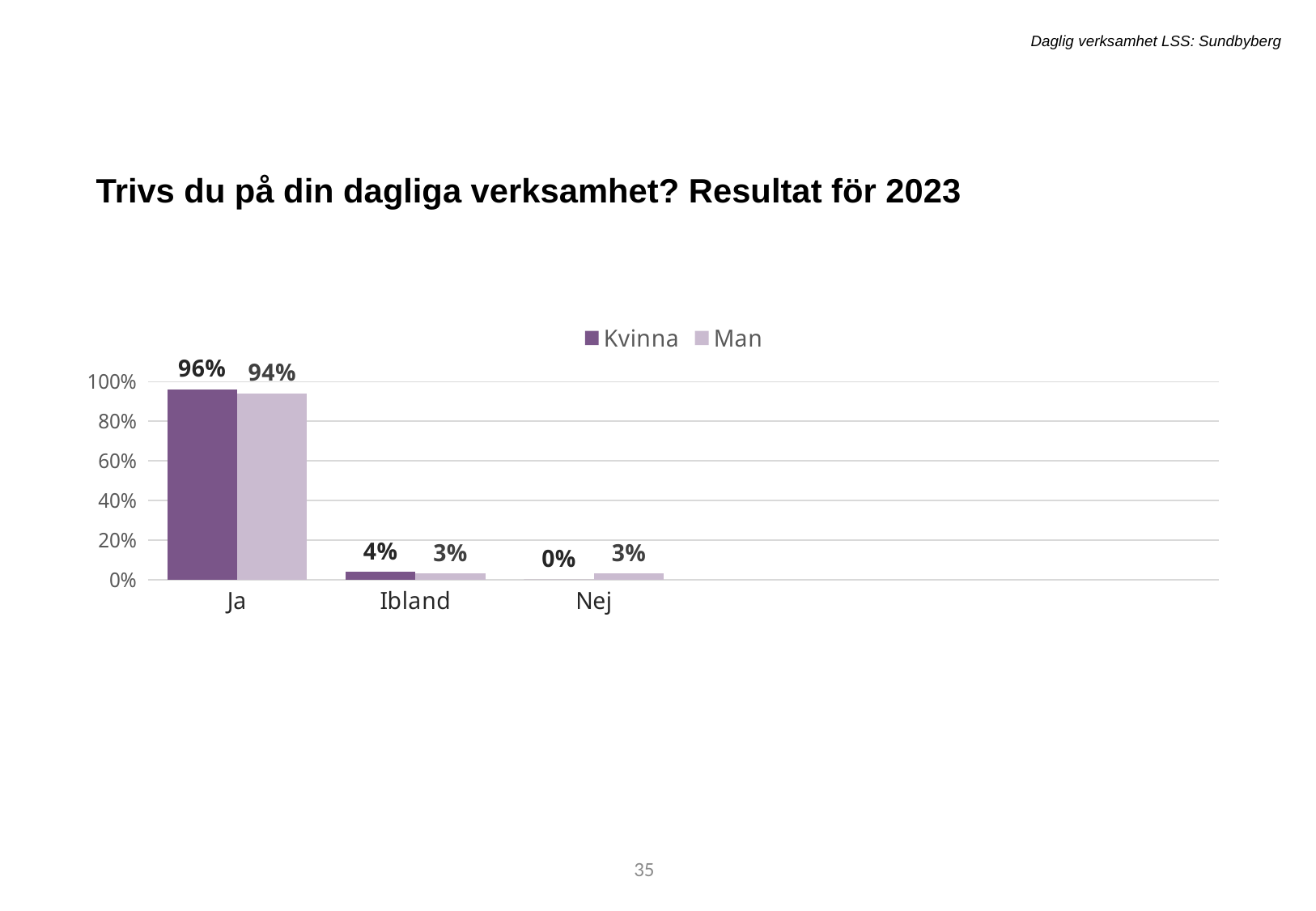
How many categories are shown on the x axis? 3 What is the value for Kvinna in the Ibland category? 4% What kind of chart is shown on the slide? Bar chart What is the difference between the Kvinna and Man values in the Ja category? 2 percentage points Which category has the highest value for Kvinna? Ja What is the value for Kvinna in the Ja category? 96% Which category has the lowest value for Man? Ibland and Nej (both 3%) What is the value for Kvinna in the Nej category? 0% What is the value for Man in the Ja category? 94% What is the value for Man in the Nej category? 3% How many series does the legend list? 2 In the Ibland category, which series has the larger value, Kvinna or Man? Kvinna